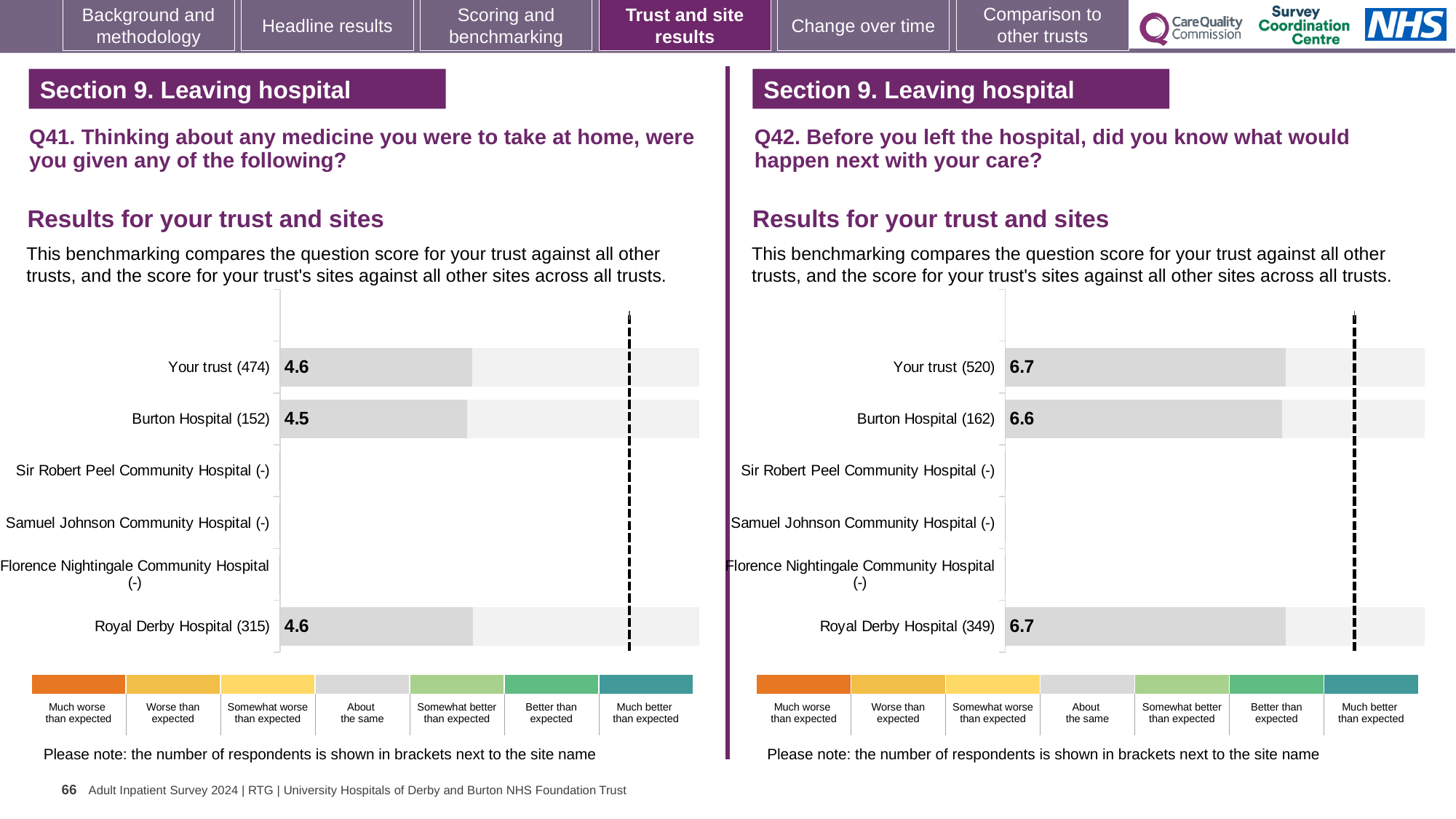
On the Q41 chart (left), how many respondents are shown in brackets for Royal Derby Hospital? 315 On the Q42 chart (right), how many respondents are shown in brackets for Your trust? 520 On the Q41 chart (left), what is the score for Royal Derby Hospital? 4.6 On the Q42 chart (right), what is the score for Your trust? 6.7 On the Q42 chart (right), what is the score for Burton Hospital? 6.6 On the Q42 chart (right), how many site or trust categories are listed on the vertical axis? 6 On the Q41 chart (left), what is the score for Your trust? 4.6 On the Q42 chart (right), what is the difference between the scores for Royal Derby Hospital and Burton Hospital? 0.1 What kind of chart is used on the Q41 chart (left)? Bar chart On the Q41 chart (left), what is the difference between the scores for Your trust and Burton Hospital? 0.1 On the Q42 chart (right), what is the score for Royal Derby Hospital? 6.7 On the Q41 chart (left), what is the score for Burton Hospital? 4.5